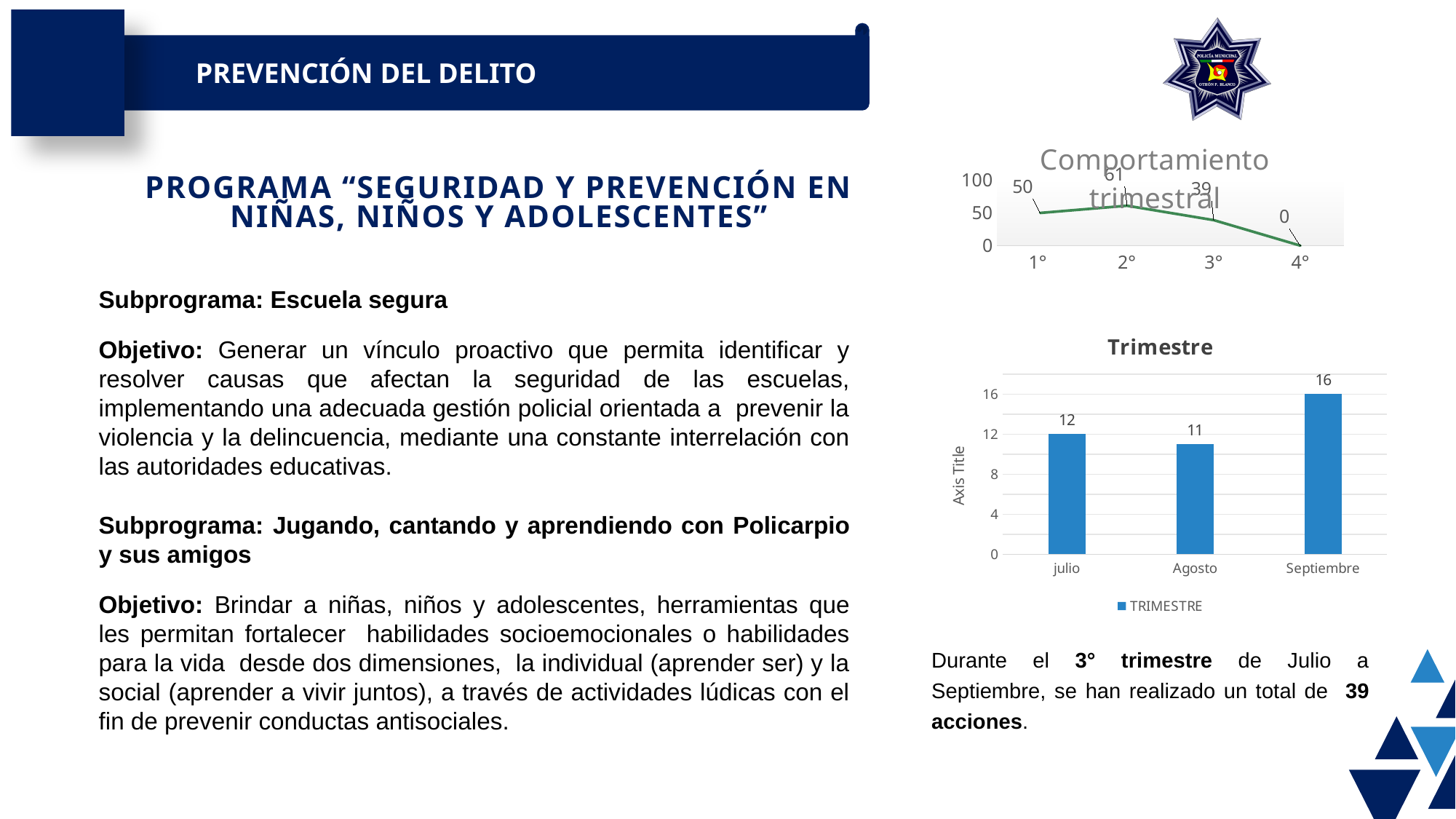
In the "Trimestre" chart, what is the difference between the values for Septiembre and julio? 4 In the "Trimestre" chart, which month has the lowest value? Agosto In the "Trimestre" chart, which month has the highest value? Septiembre What kind of chart is the "Comportamiento trimestral" chart? Line chart In the "Comportamiento trimestral" chart, what is the difference between the values for 1° and 3°? 11 In the "Trimestre" chart, what is the value for Septiembre? 16 What kind of chart is the "Trimestre" chart? Bar chart In the "Trimestre" chart, what is the value for Agosto? 11 In the "Trimestre" chart, how many categories are shown on the x axis? 3 In the "Comportamiento trimestral" chart, which quarter has the highest value? 2° In the "Trimestre" chart, what is the name of the series listed in the legend? TRIMESTRE In the "Comportamiento trimestral" chart, what is the value for 2°? 61